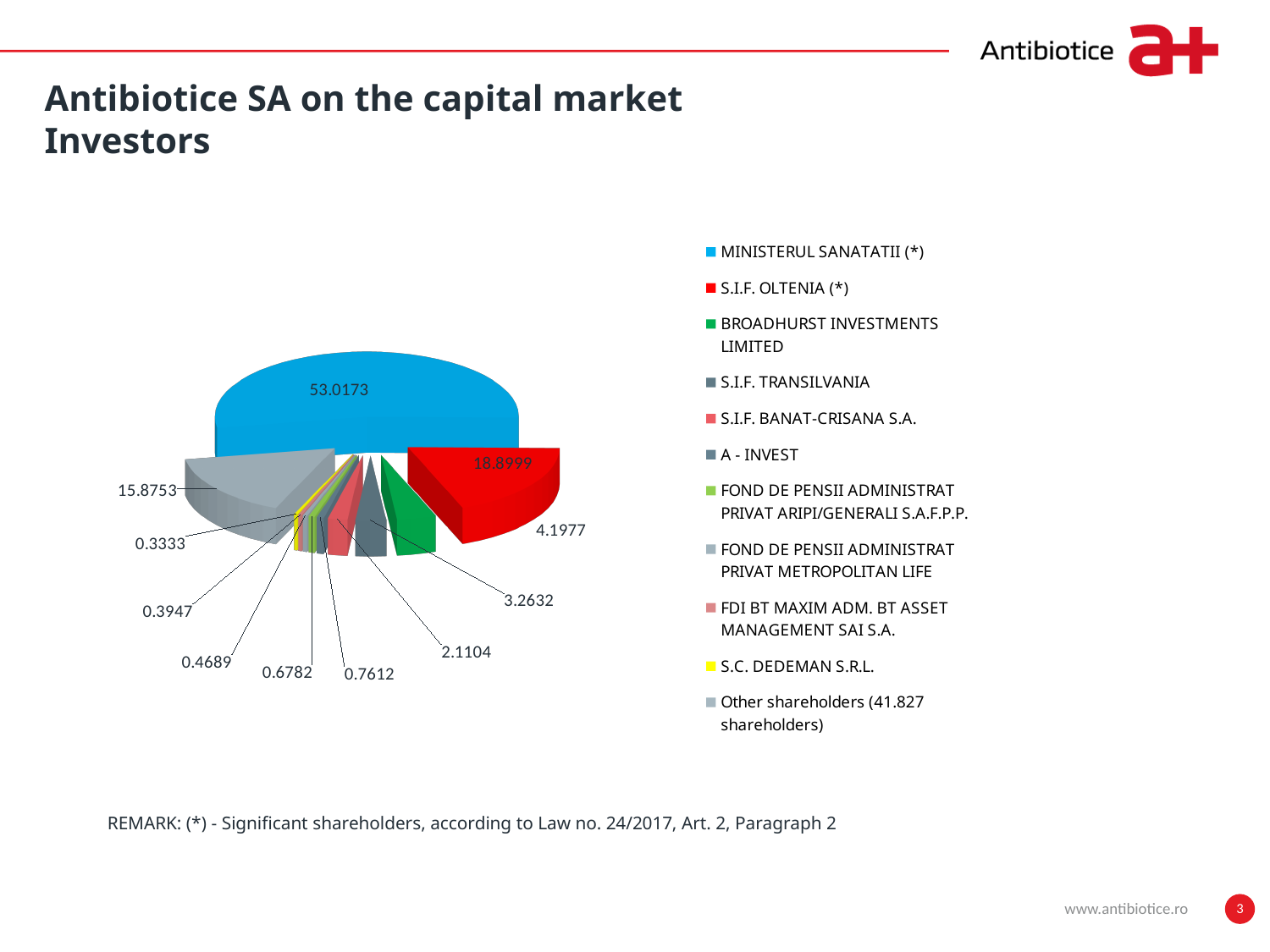
What is the value shown for Other shareholders? 15.8753 Which shareholder has the smallest slice of the pie? S.C. DEDEMAN S.R.L. Which shareholder has the largest slice of the pie? MINISTERUL SANATATII (*) Which is larger, the value for S.I.F. OLTENIA (*) or the value for Other shareholders? S.I.F. OLTENIA (*) What is the value shown for S.C. DEDEMAN S.R.L.? 0.3333 How many shareholders does the legend list? 11 What is the value shown for S.I.F. OLTENIA (*)? 18.8999 What is the value shown for MINISTERUL SANATATII (*)? 53.0173 What is the value shown for BROADHURST INVESTMENTS LIMITED? 4.1977 How many slices does the pie chart have? 11 What is the difference between the values for MINISTERUL SANATATII (*) and S.I.F. OLTENIA (*)? 34.1174 What kind of chart is shown on the slide? pie chart